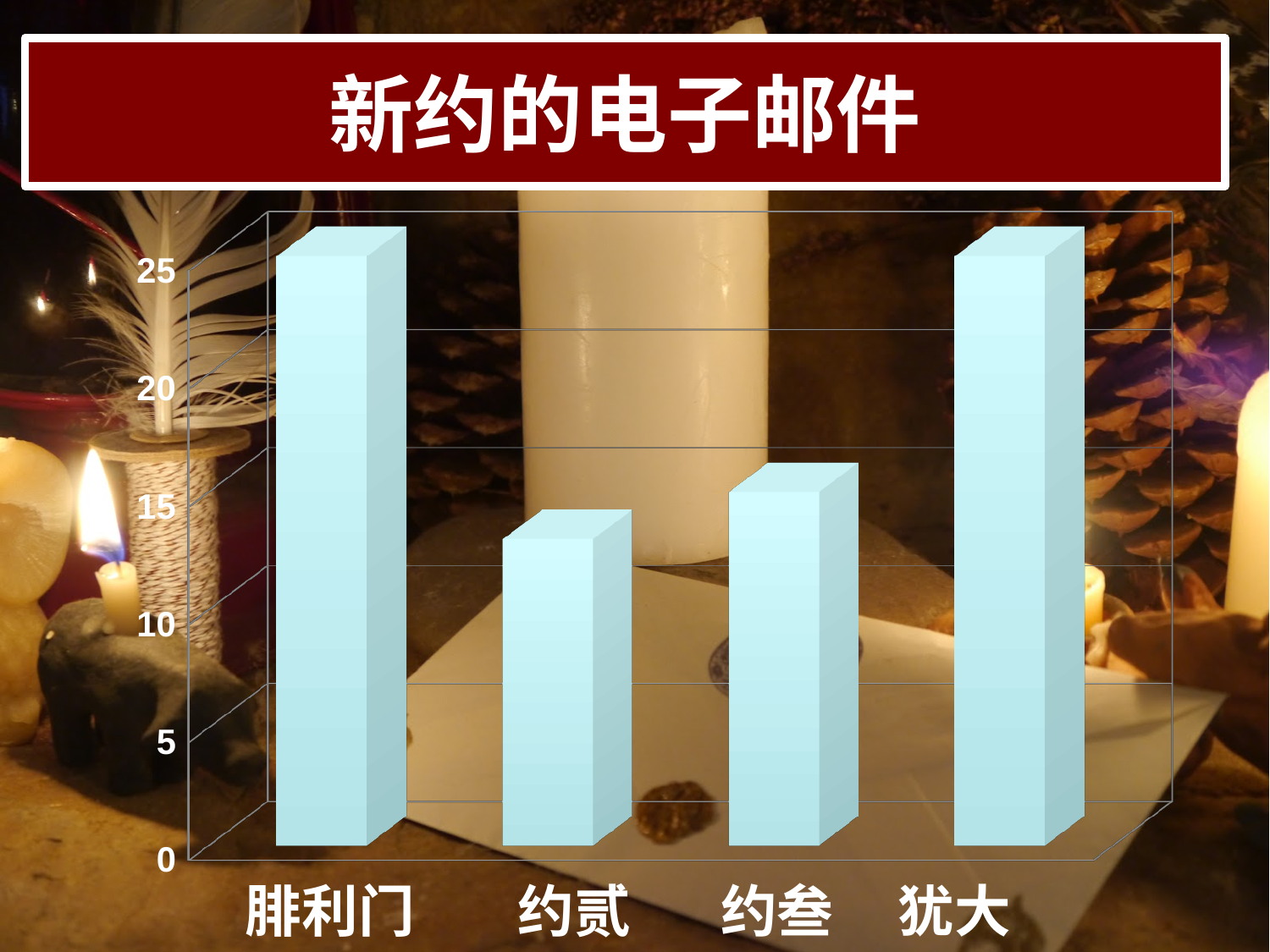
Is the value for 约叁 greater or less than 20? less What is the highest tick value shown on the vertical axis of the chart? 25 What kind of chart is shown on the slide? bar chart Is the value for 约贰 greater or less than 10? greater Which is larger, the value for 约叁 or the value for 约贰? 约叁 Is the value for 犹大 greater or less than 20? greater What is the title of the chart? 新约的电子邮件 Which is larger, the value for 腓利门 or the value for 约叁? 腓利门 Which category has the lowest bar in the chart? 约贰 How many categories are shown on the x axis of the chart? 4